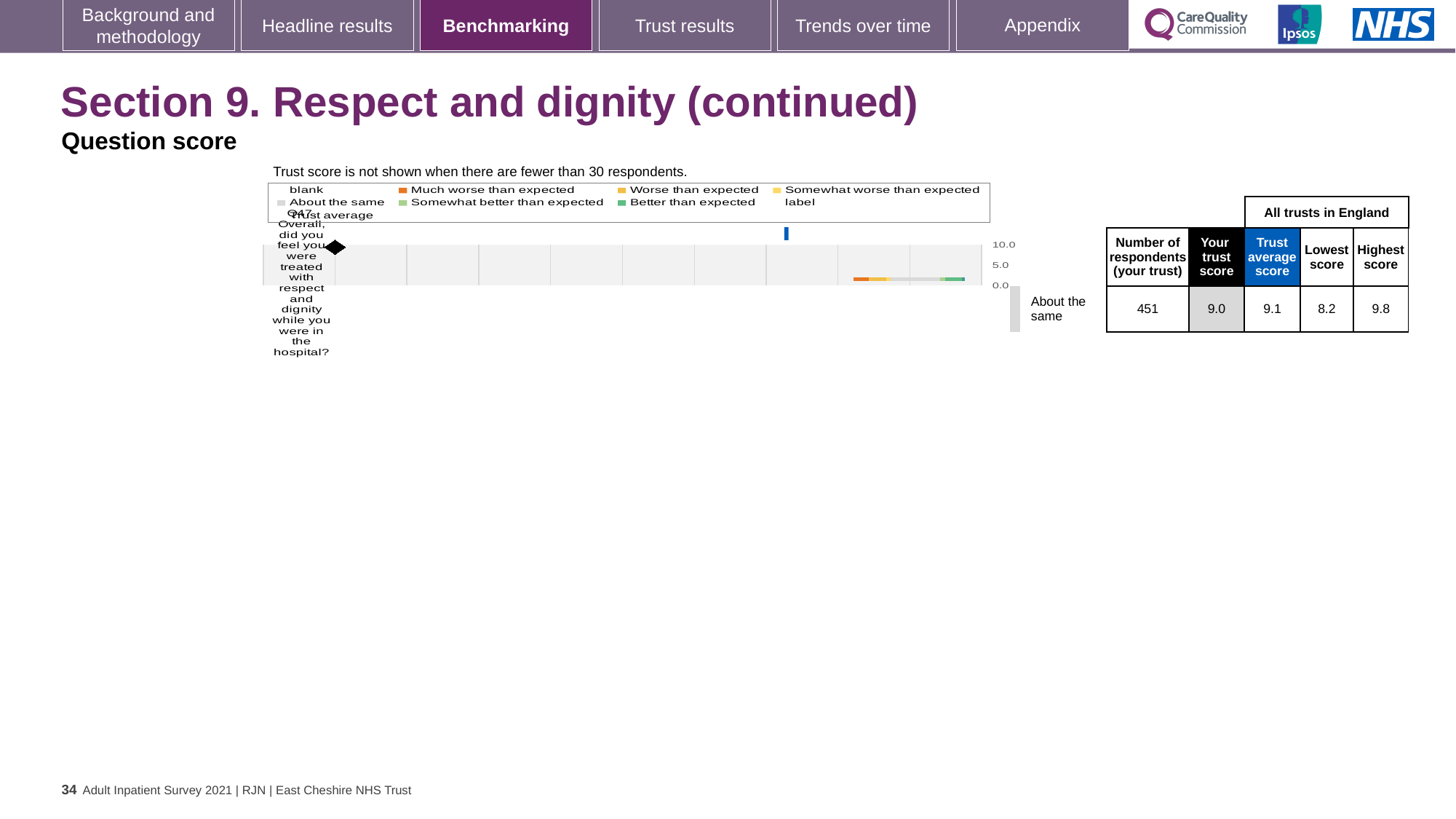
What is the trust average score for Q47 shown in the table beside the chart? 9.1 What kind of chart is shown on the slide? bar chart Which question is plotted on the chart? Q47 Which is larger for Q47, the trust score or the trust average score? Trust average score What is the difference between the highest score and the lowest score for Q47? 1.6 What is the trust score for Q47 shown in the table beside the chart? 9.0 How many questions (categories) are plotted on the chart? 1 What benchmark category is the trust's Q47 score placed in? About the same How many respondents from the trust answered Q47? 451 What is the highest tick value shown on the chart's score axis? 10.0 What is the highest score across all trusts in England for Q47? 9.8 What is the lowest score across all trusts in England for Q47? 8.2